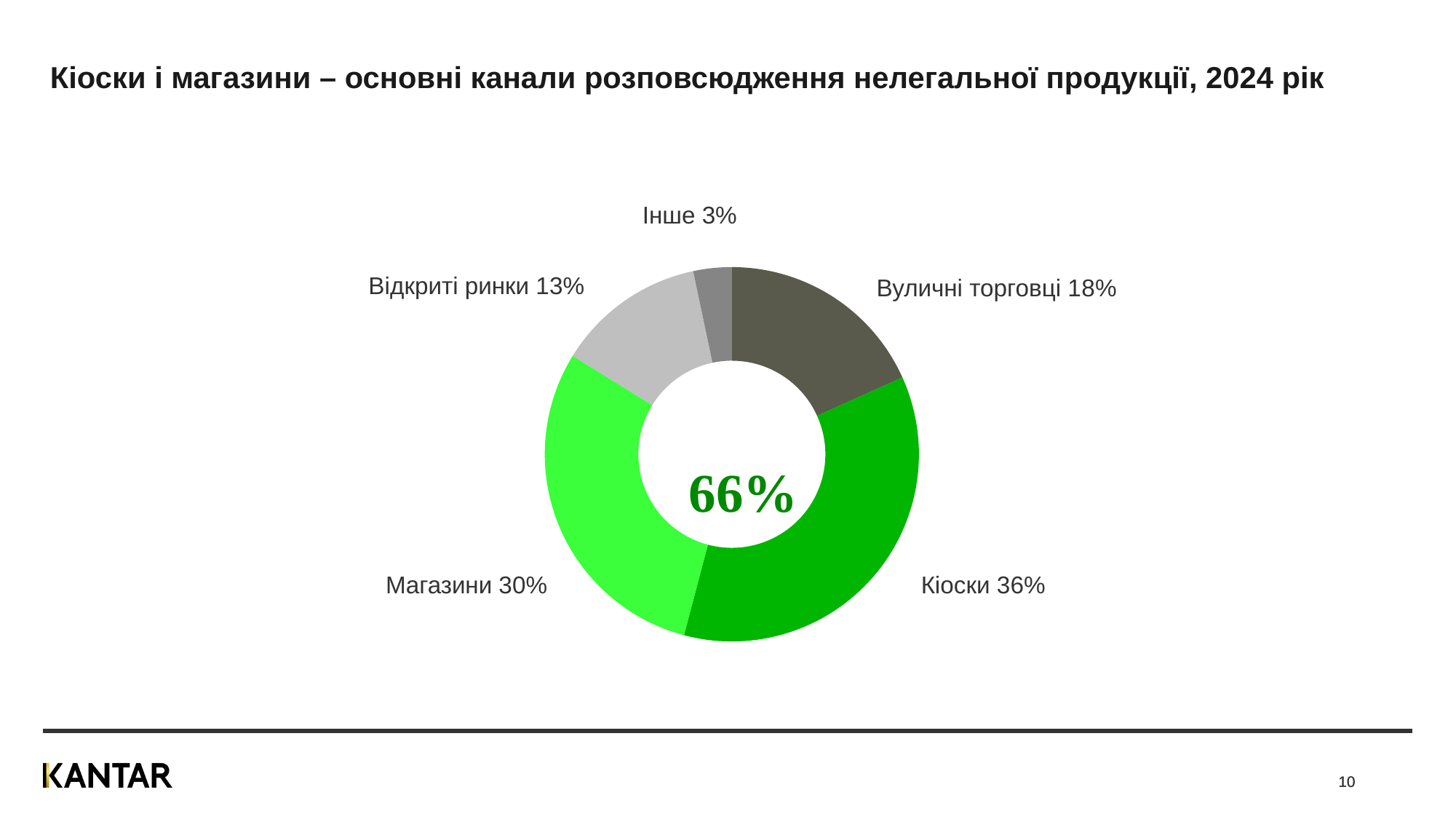
What is the value shown for Інше? 3% What number is printed in the centre of the donut chart? 66% What share of the pie does Магазини have? 30% Which category has the smallest share of the pie? Інше Which category has the largest share of the pie? Кіоски What is the difference between the shares of Кіоски and Магазини? 6% Which is larger, the share for Вуличні торговці or the share for Відкриті ринки? Вуличні торговці What is the value shown for Вуличні торговці? 18% How many categories are shown in the chart? 5 What is the value shown for Відкриті ринки? 13% What kind of chart is shown on the slide? Pie chart (donut) What share of the pie does Кіоски have? 36%